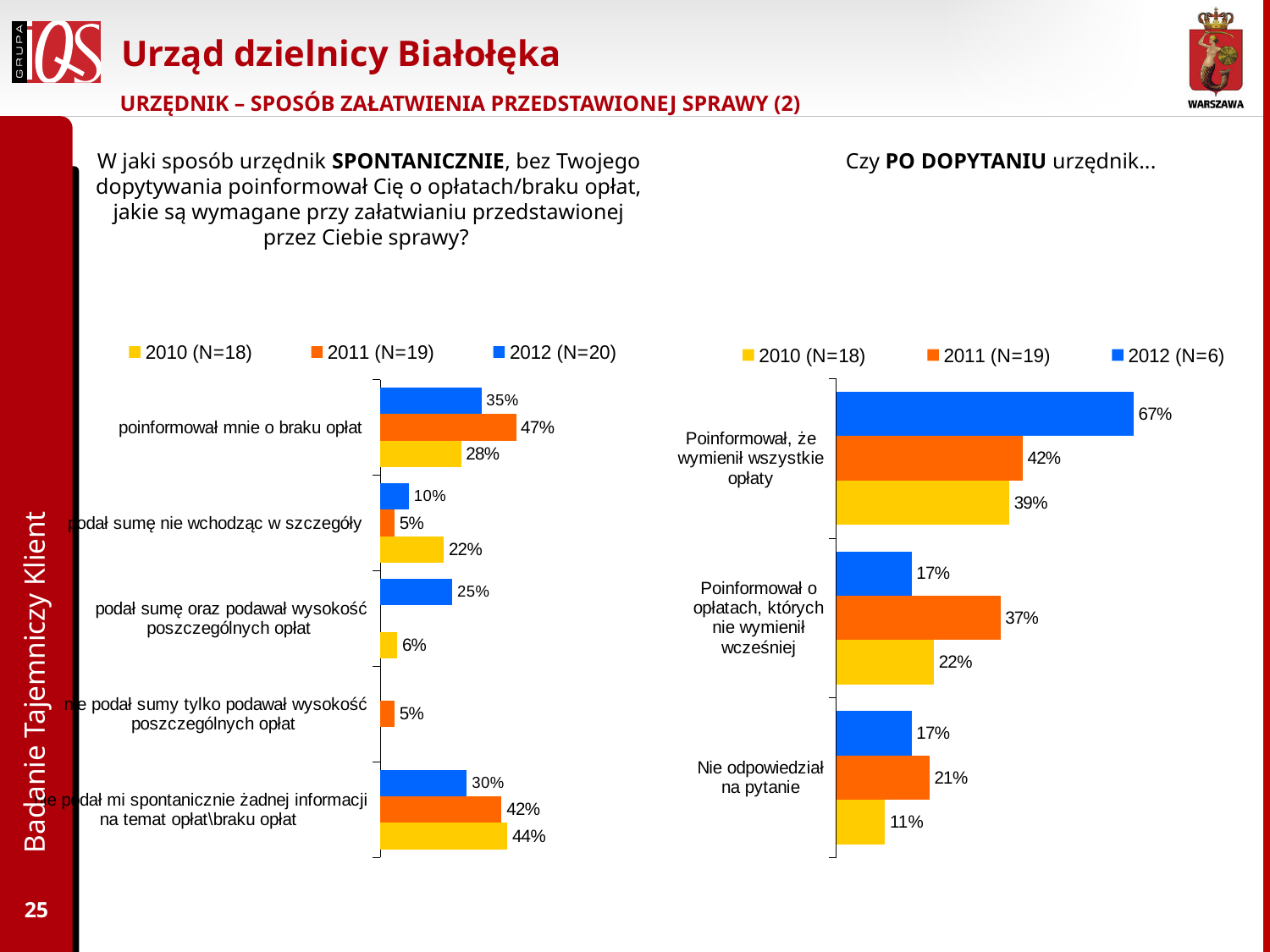
In the right chart (PO DOPYTANIU), is the 2011 value for 'Poinformował, że wymienił wszystkie opłaty' larger or smaller than the 2010 value? larger In the left chart (SPONTANICZNIE), what is the 2011 (N=19) value for 'poinformował mnie o braku opłat'? 47% In the right chart (PO DOPYTANIU), what is the 2011 (N=19) value for 'Poinformował o opłatach, których nie wymienił wcześniej'? 37% In the left chart (SPONTANICZNIE), what is the 2012 (N=20) value for 'podał sumę oraz podawał wysokość poszczególnych opłat'? 25% In the left chart (SPONTANICZNIE), what is the difference between the 2010 and 2012 values for 'nie podał mi spontanicznie żadnej informacji na temat opłat\braku opłat'? 14% In the right chart (PO DOPYTANIU), which year has the lowest value for 'Nie odpowiedział na pytanie'? 2010 (N=18) In the right chart (PO DOPYTANIU), what is the 2012 (N=6) value for 'Poinformował, że wymienił wszystkie opłaty'? 67% What type of chart is the right chart (PO DOPYTANIU)? bar chart In the left chart (SPONTANICZNIE), what is the 2010 (N=18) value for 'nie podał mi spontanicznie żadnej informacji na temat opłat\braku opłat'? 44% In the left chart (SPONTANICZNIE), which year has the highest value for 'poinformował mnie o braku opłat'? 2011 (N=19) In the left chart (SPONTANICZNIE), how many series does the legend list? 3 In the right chart (PO DOPYTANIU), how many categories are shown? 3